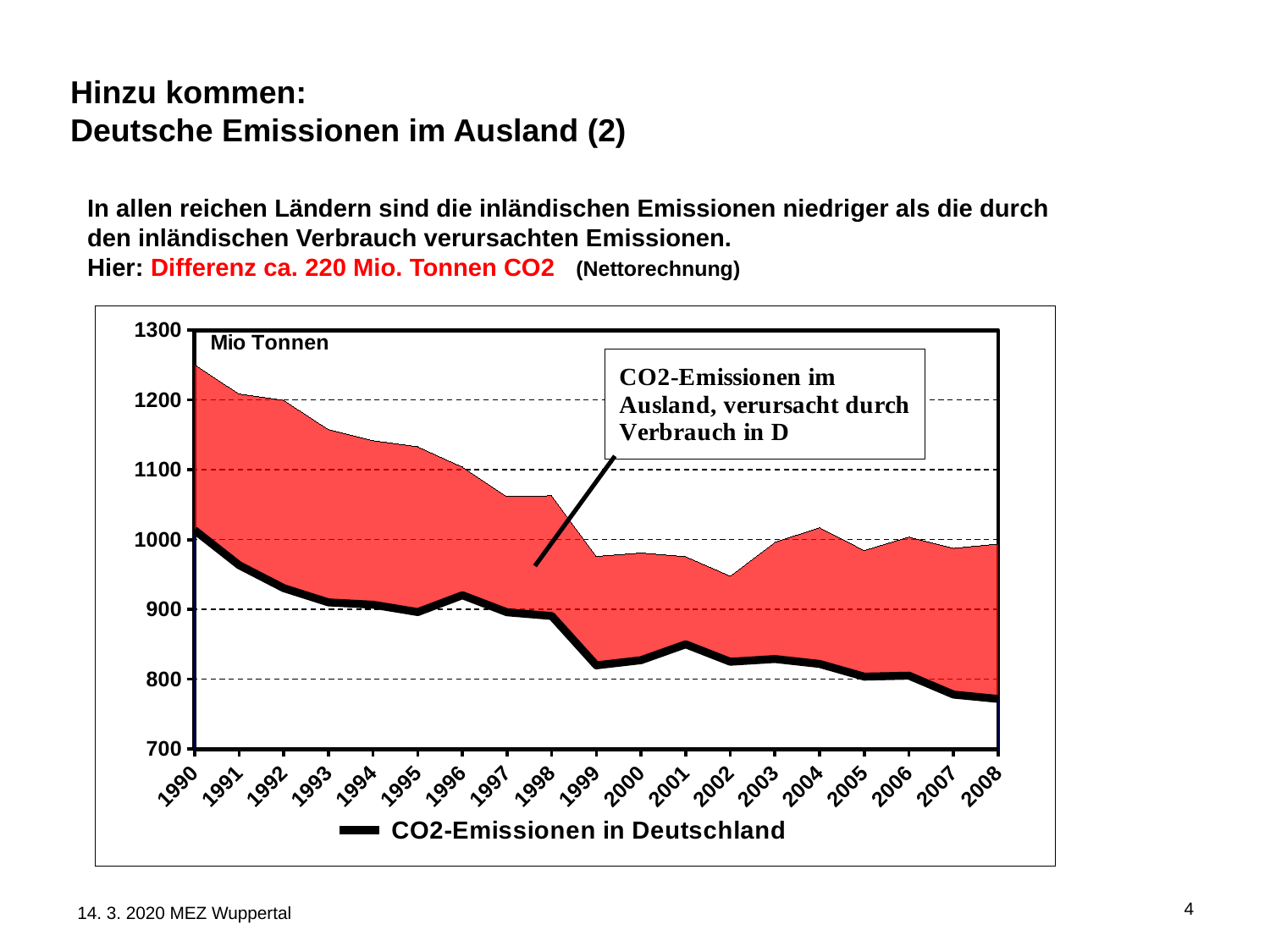
What kind of chart is used to show CO2-Emissionen in Deutschland? line chart What unit is printed at the top of the y axis of the chart? Mio Tonnen Is the top of the red area (emissions including those caused abroad) in 2002 greater or less than 1000? less How many series does the chart legend list? 1 Which year has the larger value for CO2-Emissionen in Deutschland, 1990 or 2008? 1990 Is the value for CO2-Emissionen in Deutschland in 2008 greater or less than 800? less Is the value for CO2-Emissionen in Deutschland in 1996 greater or less than 900? greater What is the name of the series listed in the chart legend? CO2-Emissionen in Deutschland In which year are the CO2-Emissionen in Deutschland highest? 1990 How many years are shown on the x axis of the chart? 19 Do the CO2-Emissionen in Deutschland rise or fall from 1990 to 2008? fall